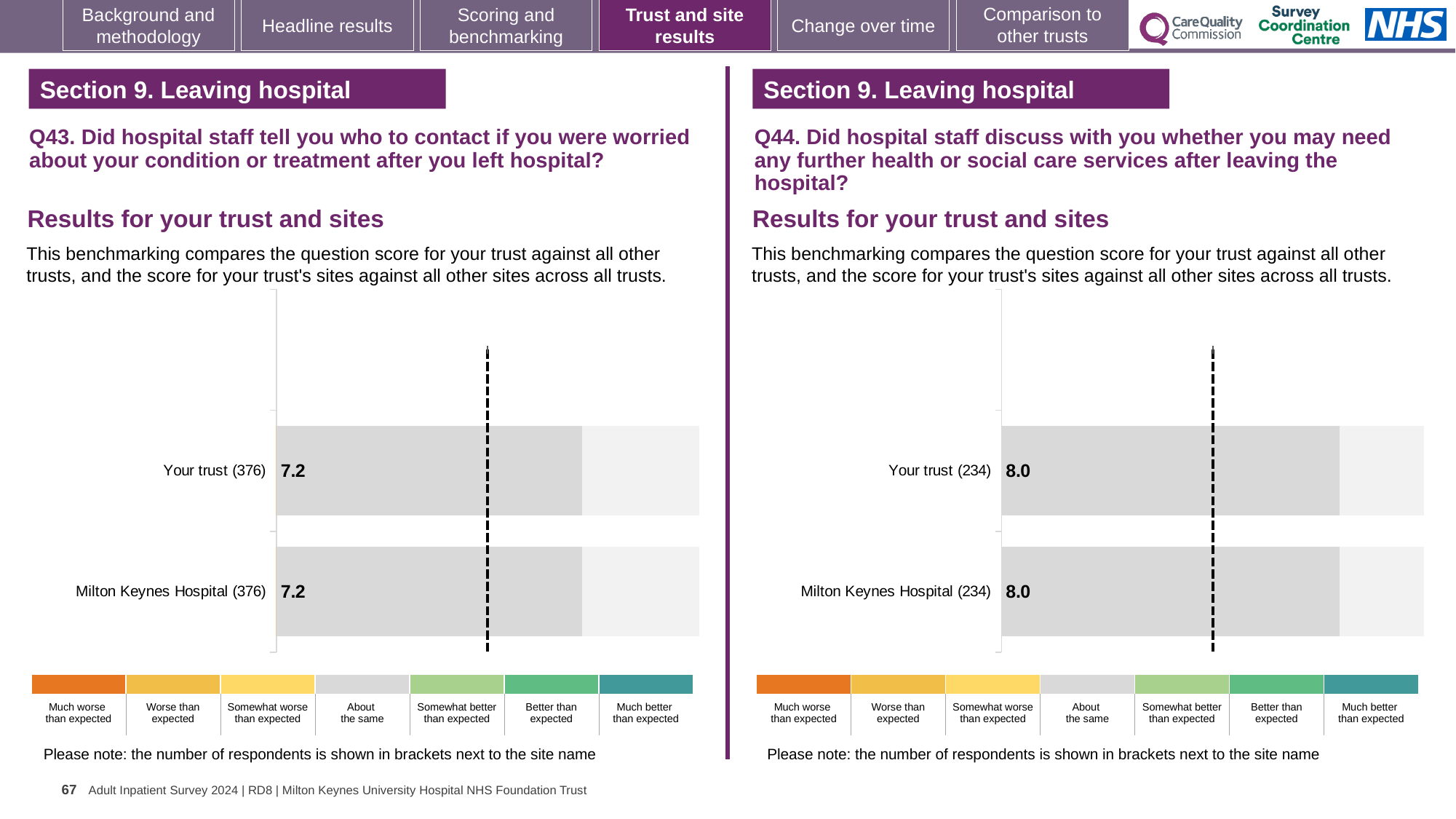
In the Q44 chart on the right, what is the score for Your trust? 8.0 In the Q43 chart on the left, how many respondents are shown in brackets for Your trust? 376 In the Q44 chart on the right, how many respondents are shown in brackets for Milton Keynes Hospital? 234 In the Q43 chart on the left, what is the score for Your trust? 7.2 How many categories does the colour key below the Q44 chart on the right list? 7 In the Q43 chart on the left, what is the difference between the score for Your trust and the score for Milton Keynes Hospital? 0.0 How many bars are plotted in the Q43 chart on the left? 2 In the Q44 chart on the right, what is the score for Milton Keynes Hospital? 8.0 How many bars are plotted in the Q44 chart on the right? 2 In the Q43 chart on the left, what is the score for Milton Keynes Hospital? 7.2 What kind of chart is used for the Q43 results on the left? Bar chart In the Q44 chart on the right, is the score for Your trust larger than, smaller than, or the same as the score for Milton Keynes Hospital? the same